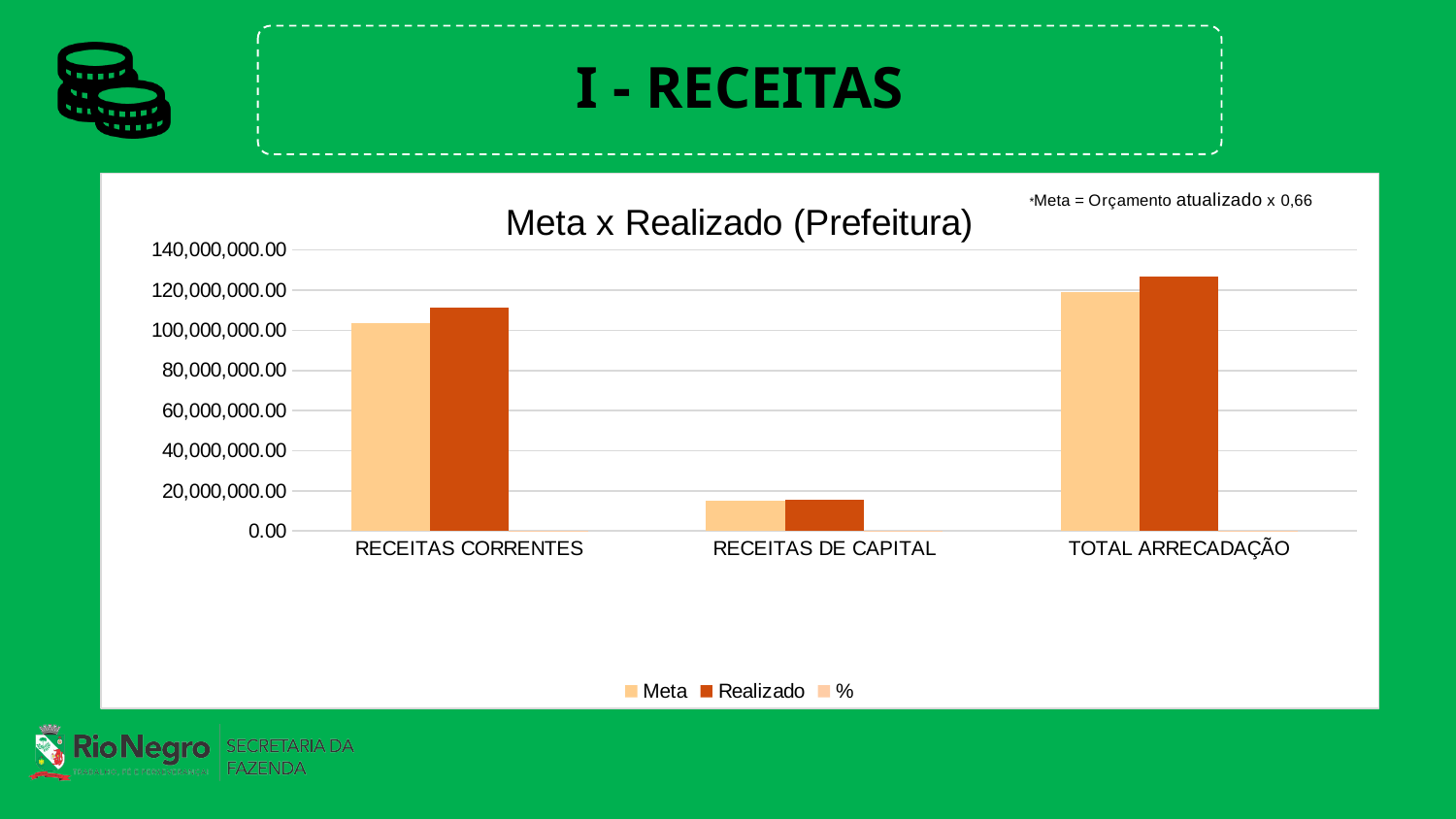
For RECEITAS CORRENTES, which is larger: Meta or Realizado? Realizado Is the Realizado value for RECEITAS CORRENTES greater or less than 100,000,000.00? greater Is the Realizado value for TOTAL ARRECADAÇÃO greater or less than 120,000,000.00? greater Which category has the lowest Meta value? RECEITAS DE CAPITAL Is the Meta value for RECEITAS DE CAPITAL greater or less than 20,000,000.00? less How many series does the chart legend list? 3 For TOTAL ARRECADAÇÃO, which is larger: Meta or Realizado? Realizado Which category has the highest Realizado value? TOTAL ARRECADAÇÃO How many categories are shown on the x axis of the chart? 3 What kind of chart is shown on the slide? Bar chart What is the title of the chart? Meta x Realizado (Prefeitura) What are the entries listed in the chart legend? Meta, Realizado, %